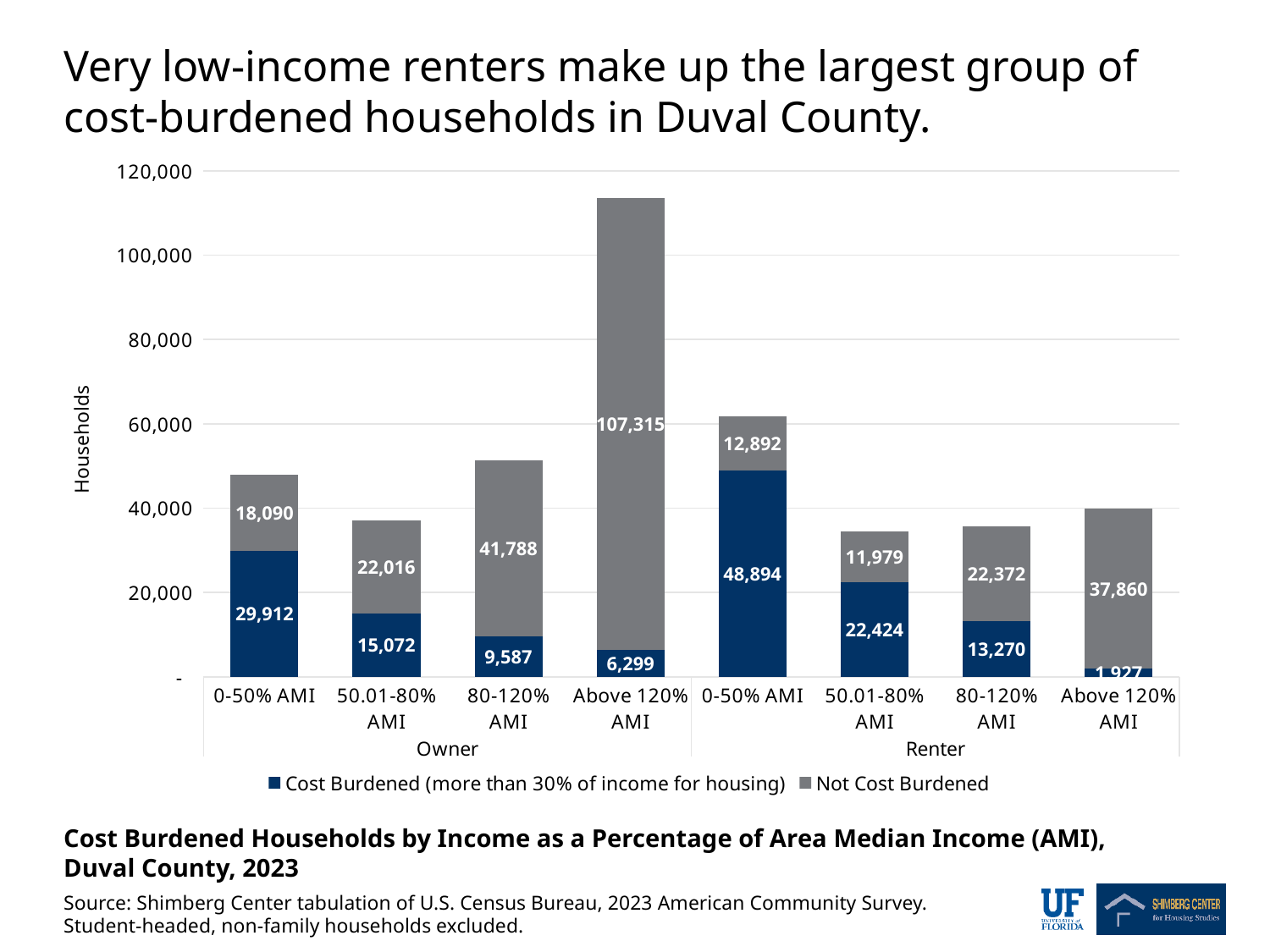
Which group has the smallest number of cost-burdened households? Renter Above 120% AMI How many income groups (bars) are shown on the chart? 8 How many cost-burdened owner households are in the 0-50% AMI group? 29,912 Which group has the largest number of cost-burdened households? Renter 0-50% AMI What is the difference between cost-burdened renter households and cost-burdened owner households in the 0-50% AMI group? 18,982 What kind of chart is shown on the slide? Stacked bar chart How many not-cost-burdened renter households are in the Above 120% AMI group? 37,860 Which is larger: the number of not-cost-burdened owner households at 80-120% AMI or the number of not-cost-burdened renter households at 80-120% AMI? Owner 80-120% AMI How many series does the legend list? 2 How many cost-burdened renter households are in the 80-120% AMI group? 13,270 What is the total number of households in the Renter 0-50% AMI bar? 61,786 Is the total height of the Owner Above 120% AMI bar greater or less than 100,000? greater